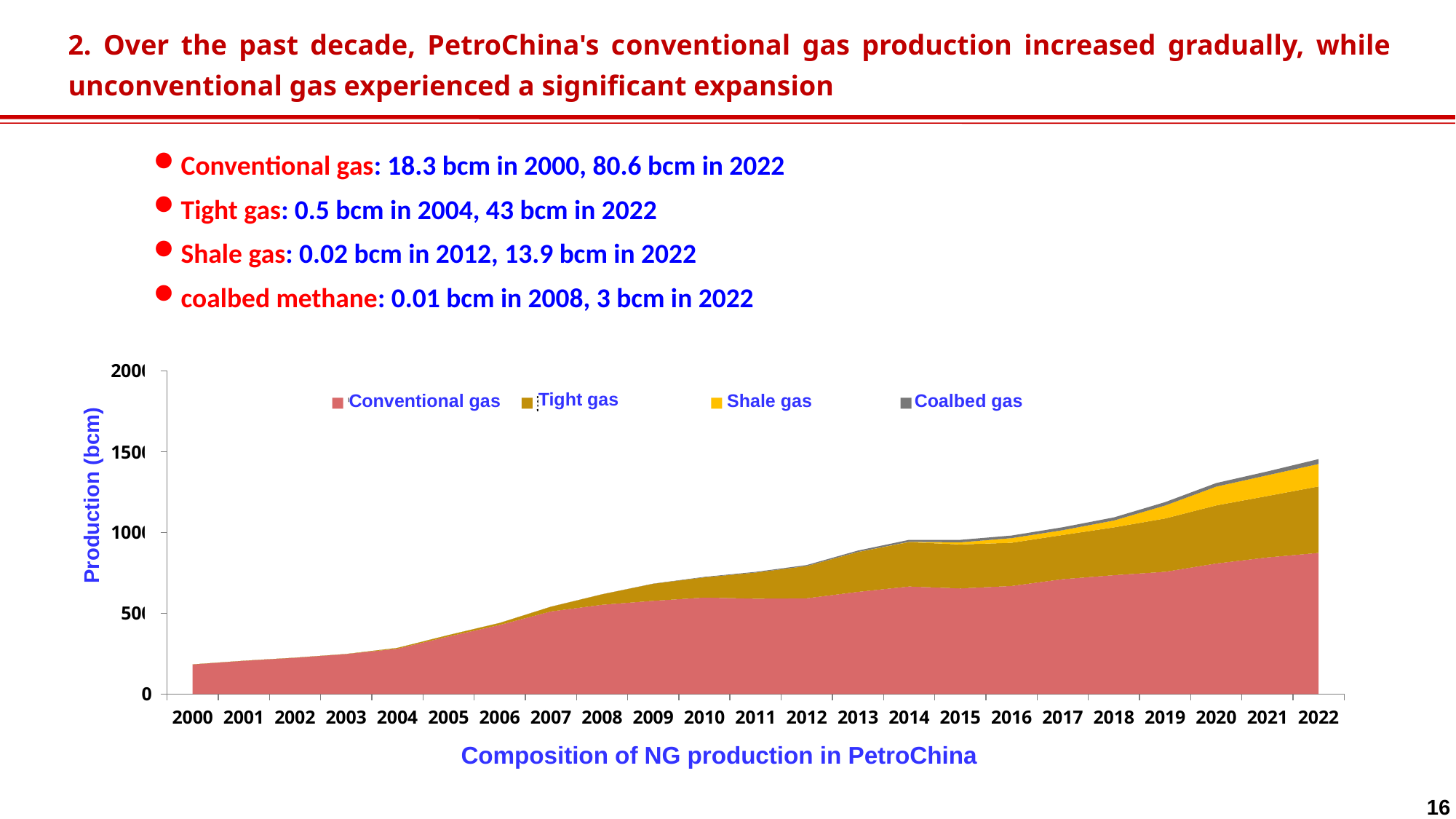
What is the title of the chart? Composition of NG production in PetroChina Which series accounts for the largest share of production in 2022? Conventional gas What is the last year shown on the x axis? 2022 What is the label of the y axis? Production (bcm) In 2022, which is larger: Conventional gas or Tight gas? Conventional gas Does total production rise or fall from 2000 to 2022? Rise In 2022, which is larger: Tight gas or Shale gas? Tight gas How many years are shown along the x axis? 23 Which series accounts for the smallest share of production in 2022? Coalbed gas What is the first year shown on the x axis? 2000 How many series does the legend list? 4 What kind of chart is shown on the slide? Stacked area chart